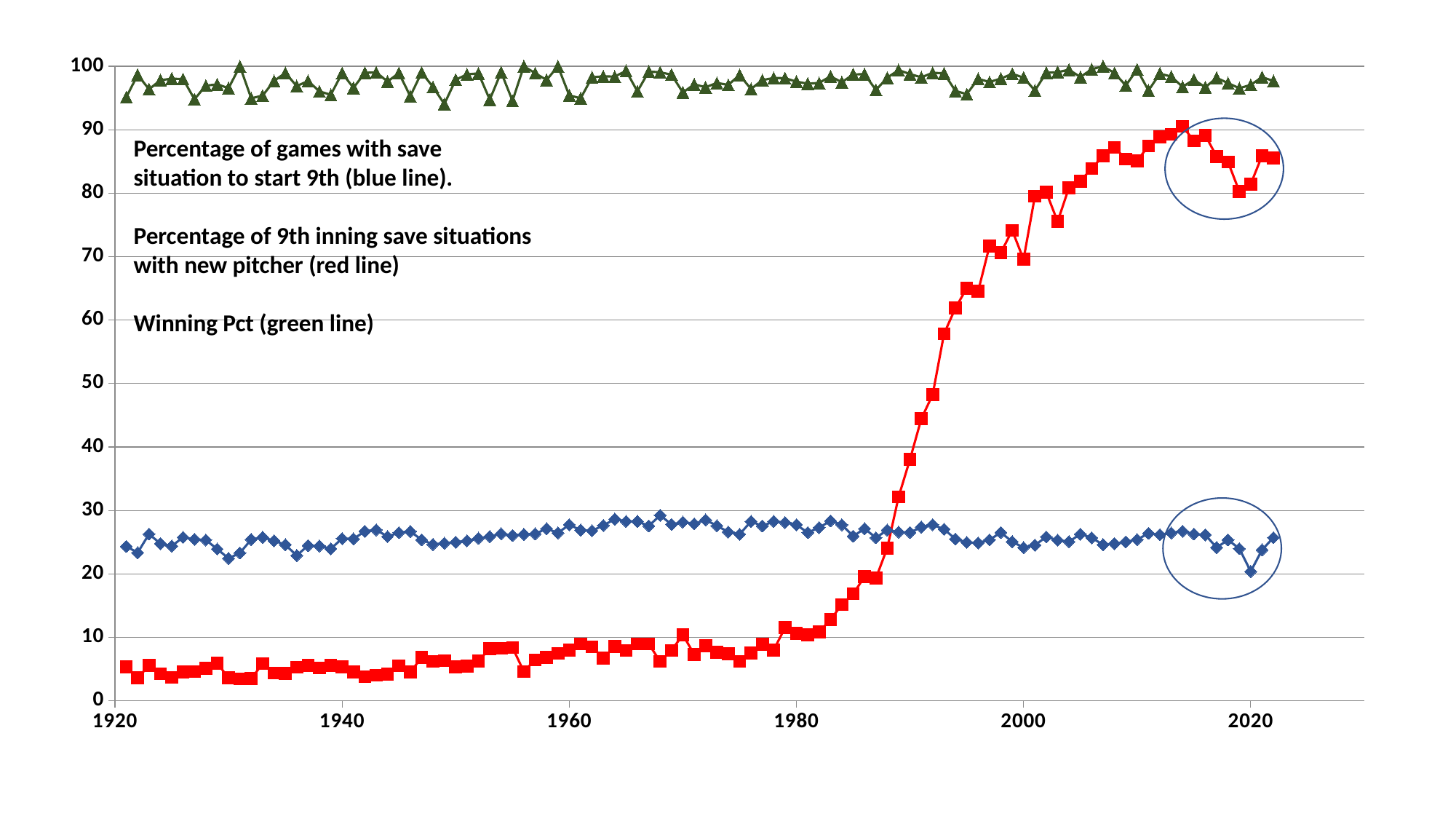
Which of the three lines has the highest values across the whole chart? the green line (Winning Pct) Is the value of the red line in 2010 greater or less than 80? greater Is the value of the green line in 1980 greater or less than 90? greater Which series does the green line represent? Winning Pct What kind of chart is shown on the slide? line chart In 2000, which is larger: the red line or the blue line? the red line In 1940, which is larger: the green line or the red line? the green line Does the red line rise or fall between 1980 and 2000? rise Is the value of the blue line in 1960 greater or less than 30? less How many data series (lines) are plotted on the chart? 3 What does the red line represent? Percentage of 9th inning save situations with new pitcher